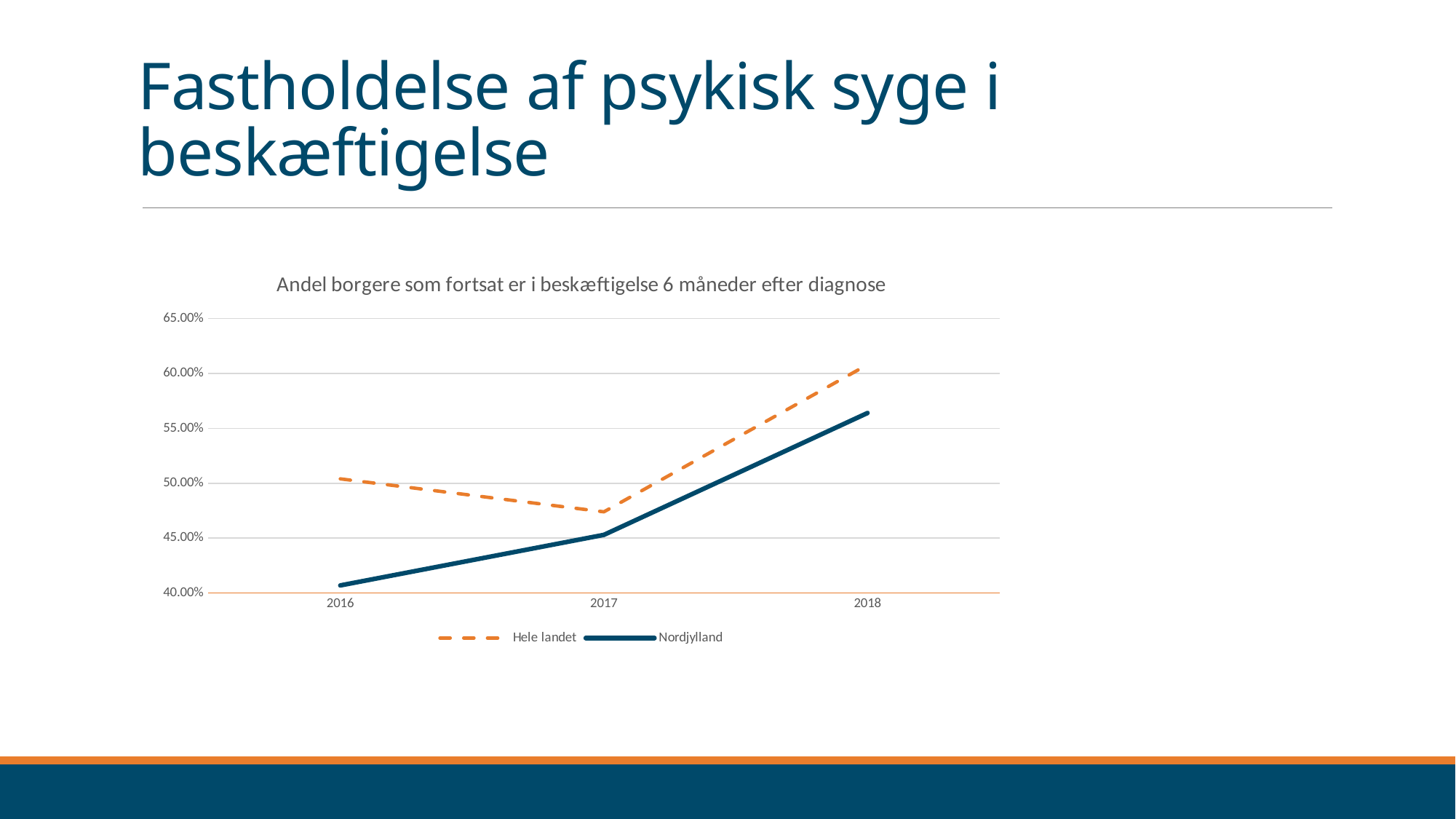
What is the title of the chart? Andel borgere som fortsat er i beskæftigelse 6 måneder efter diagnose In which year is the Hele landet value lowest? 2017 In which year is the Nordjylland value highest? 2018 What kind of chart is shown on the slide? line chart In which year is the Nordjylland value lowest? 2016 How many series does the legend list? 2 How many years are shown on the x axis? 3 Is the value for Nordjylland in 2016 greater or less than 45.00%? less Is the value for Hele landet in 2017 greater or less than 50.00%? less Which series is drawn with a dashed orange line? Hele landet In 2016, which series has the higher value, Hele landet or Nordjylland? Hele landet Does the Nordjylland line rise or fall from 2016 to 2018? rise